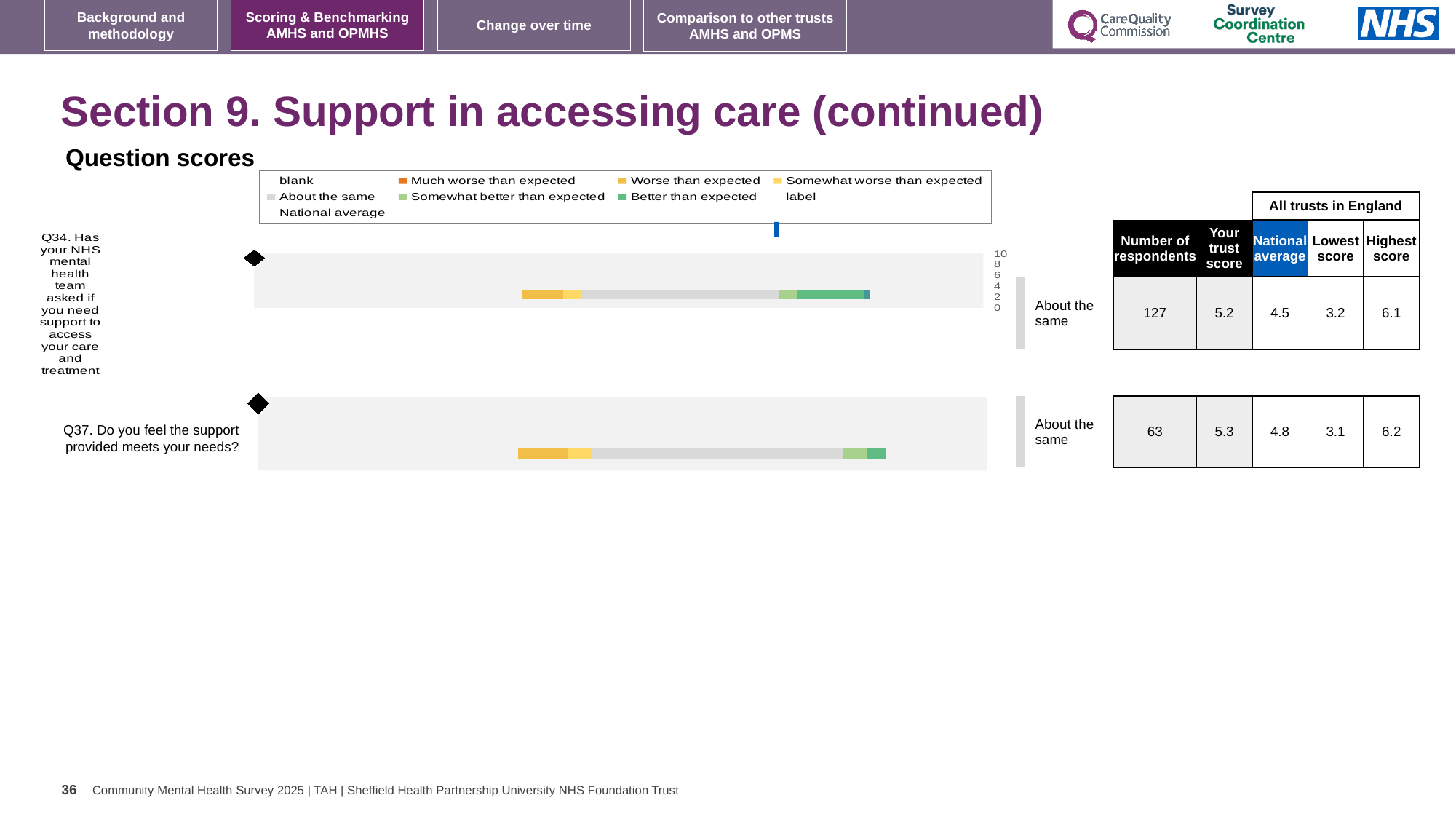
How many entries does the legend above the question scores charts list? 9 How many questions are plotted in the question scores charts? 2 How many respondents answered Q34? 127 What is the 'Your trust score' value for Q34? 5.2 What rating is shown next to the bar for Q34? About the same What is the national average score for Q37? 4.8 What rating is shown next to the bar for Q37 'Do you feel the support provided meets your needs?' About the same Which question has the higher 'Your trust score', Q34 or Q37? Q37 What kind of chart is used to show the question scores for Q34 and Q37? bar chart Which colour in the legend represents 'Better than expected'? green What is the highest score among all trusts in England for Q37? 6.2 What is the difference between the trust score and the national average for Q34? 0.7